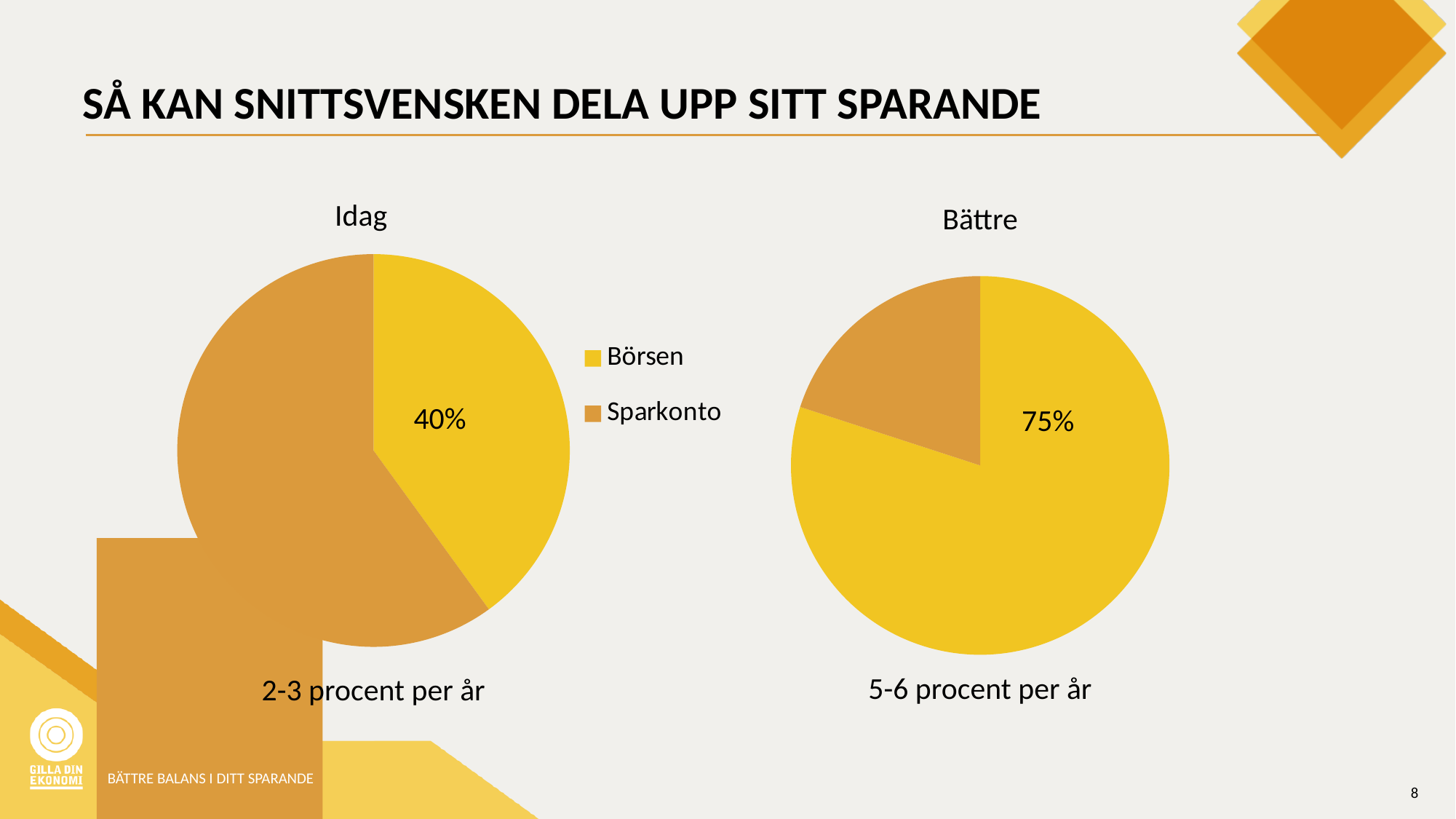
What are the two legend entries shown between the pie charts? Börsen and Sparkonto In the "Bättre" pie chart, what share does Börsen have? 75% In the "Idag" pie chart, which slice is larger, Börsen or Sparkonto? Sparkonto How many slices does the "Bättre" pie chart have? 2 How many entries does the legend between the two charts list? 2 What kind of chart is the "Idag" chart? Pie chart What is the title of the pie chart on the right? Bättre By how many percentage points is the Börsen share in the "Bättre" chart higher than in the "Idag" chart? 35 percentage points In the "Bättre" pie chart, is the Börsen share greater or less than 50%? greater In the "Idag" pie chart, what share does Börsen have? 40% In the "Idag" pie chart, is the Börsen share greater or less than 50%? less In the "Bättre" pie chart, which slice is larger, Börsen or Sparkonto? Börsen